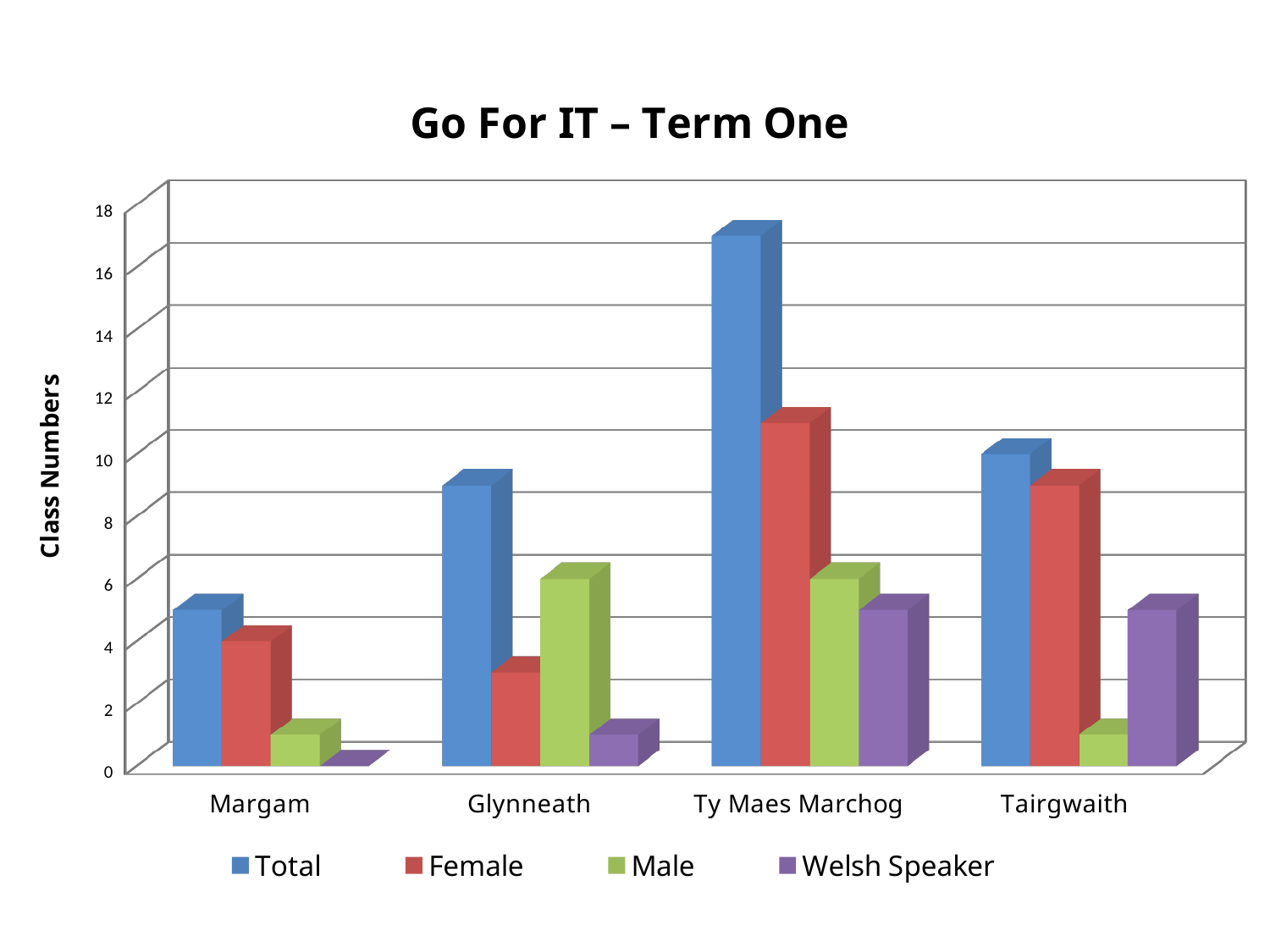
Which is larger for Glynneath, the Male value or the Female value? Male What type of chart is shown on the slide? bar chart What is the label on the vertical axis? Class Numbers Is the Total value for Ty Maes Marchog greater or less than 16? greater What is the title of the chart? Go For IT – Term One Is the Total value for Glynneath greater or less than 8? greater Is the Female value for Glynneath greater or less than 4? less How many categories (schools) are shown on the x axis? 4 Which category has the lowest Total value? Margam Which is larger for Tairgwaith, the Welsh Speaker value or the Male value? Welsh Speaker Which category has the highest Total value? Ty Maes Marchog How many series does the legend list? 4